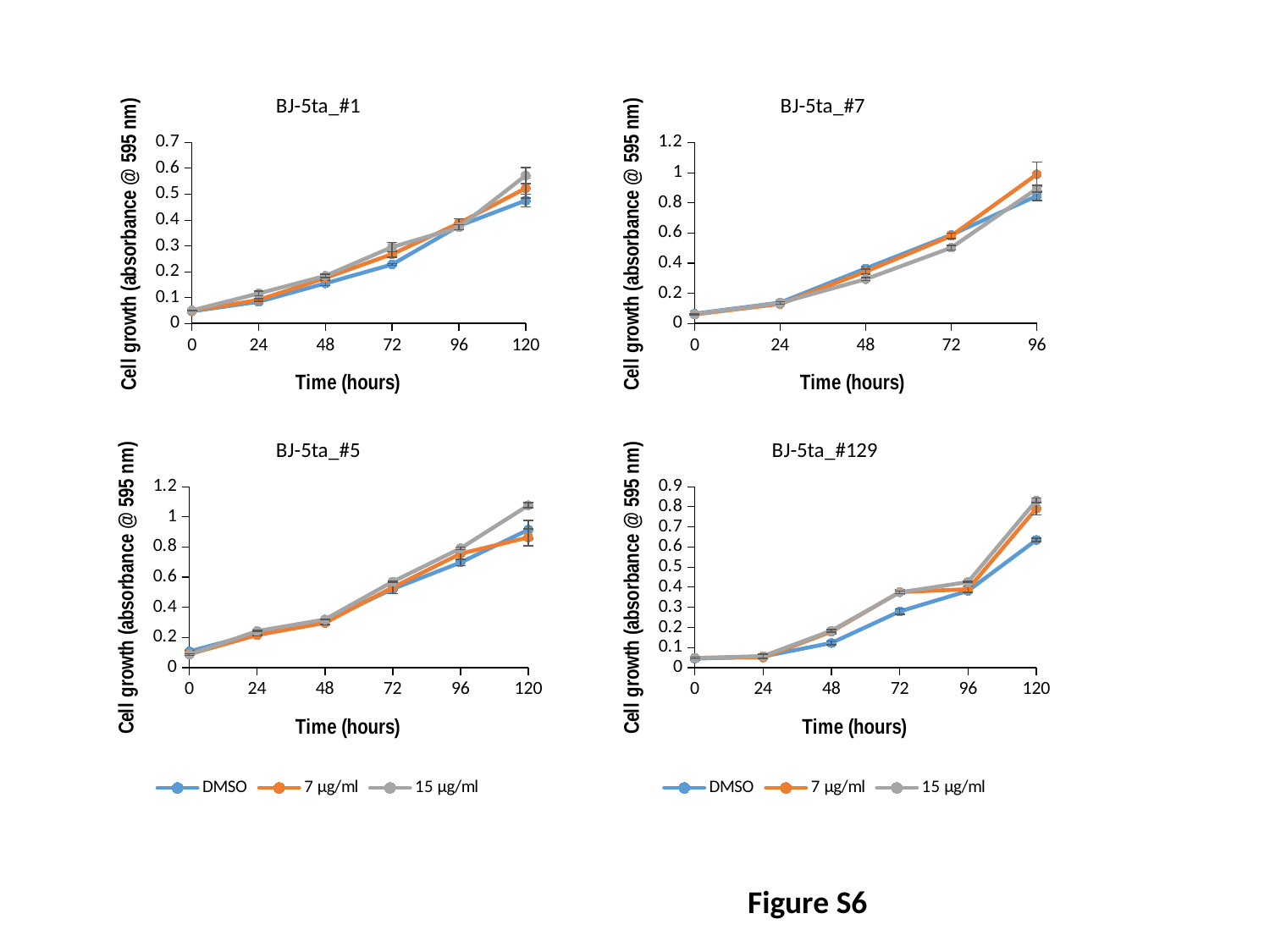
In the BJ-5ta_#129 chart, is the value for 7 µg/ml at 72 hours greater or less than 0.3? greater In the BJ-5ta_#5 chart, which series has the highest value at 120 hours? 15 µg/ml What kind of chart is BJ-5ta_#1? line chart What is the y-axis label of the BJ-5ta_#5 chart? Cell growth (absorbance @ 595 nm) How many series does the legend list for the BJ-5ta_#5 chart? 3 In the BJ-5ta_#7 chart, which series has the highest value at 96 hours? 7 µg/ml How many time points are plotted on the x axis of the BJ-5ta_#7 chart? 5 In the BJ-5ta_#129 chart, which series has the lowest value at 120 hours? DMSO How many time points are plotted on the x axis of the BJ-5ta_#129 chart? 6 In the BJ-5ta_#1 chart, do the values rise or fall as time increases? rise In the BJ-5ta_#7 chart, is the value for 7 µg/ml at 96 hours greater or less than 0.8? greater In the BJ-5ta_#129 chart, is the value for 15 µg/ml at 120 hours greater or less than 0.7? greater